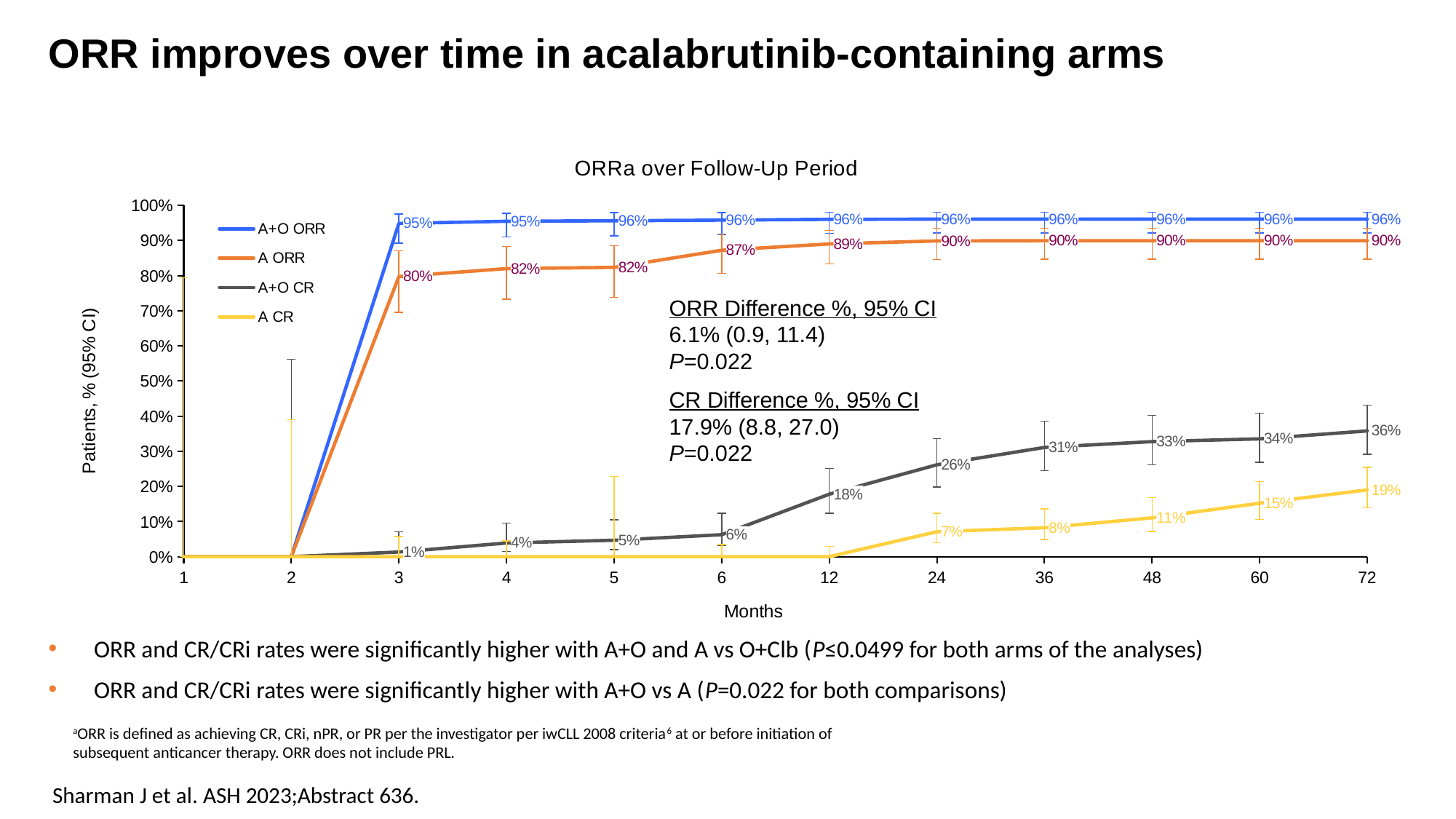
What is the title of the chart? ORRa over Follow-Up Period How many month tick marks are shown on the x axis? 12 What type of chart is shown on the slide? line chart What is the A+O CR value at 12 months? 18% Does the A+O CR series rise or fall from 3 months to 72 months? rise How many series does the legend list? 4 What is the difference between the A+O ORR and A ORR values at 3 months? 15% What is the A ORR value at 3 months? 80% At 24 months, which is larger: A+O CR or A CR? A+O CR What is the A+O ORR value at 72 months? 96% What is the difference between the A+O CR and A CR values at 72 months? 17% What is the A CR value at 48 months? 11%